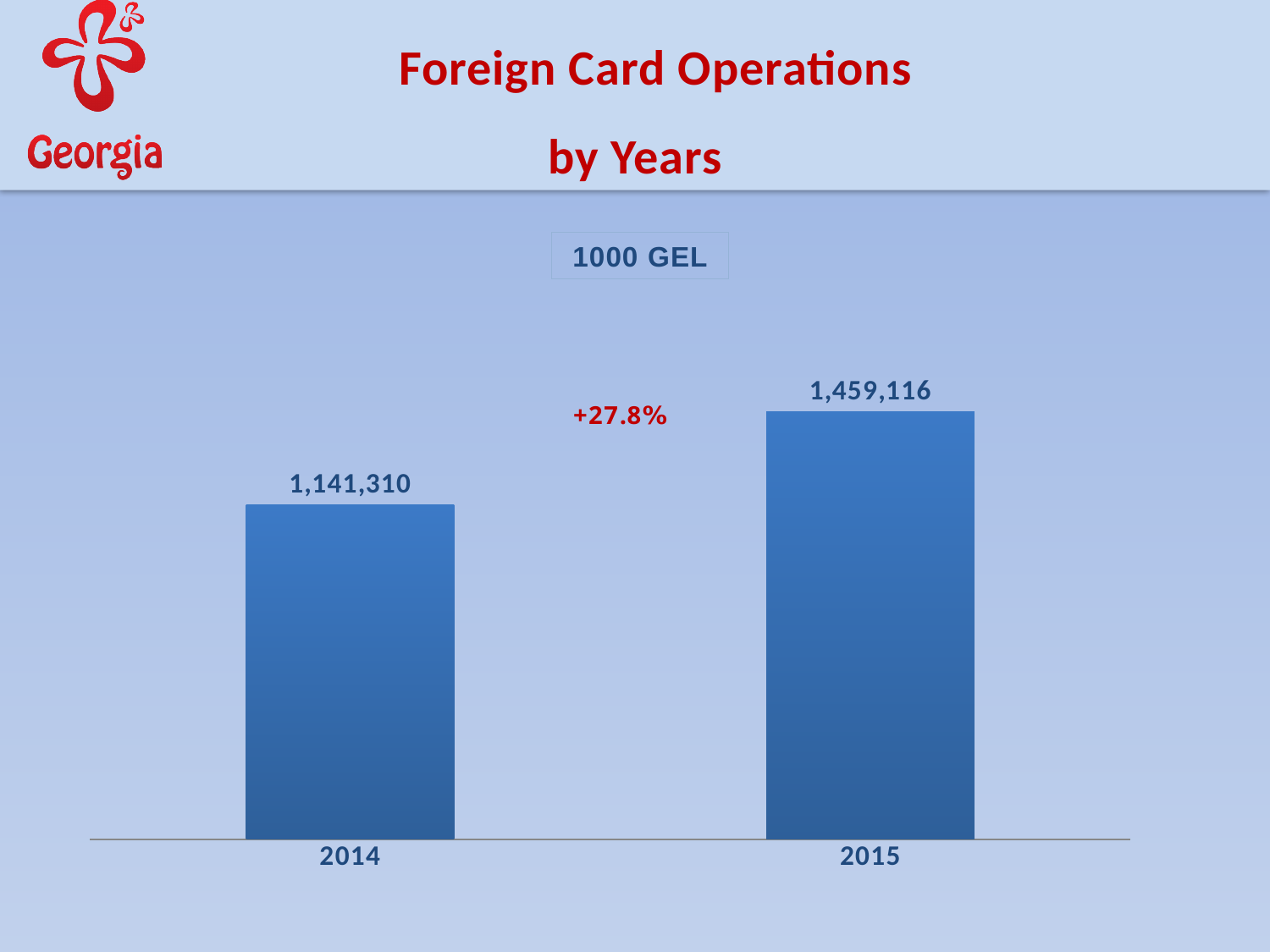
What is the value for 2015? 1,459,116 Which is larger, the value for 2014 or the value for 2015? 2015 What percentage change is annotated between 2014 and 2015? +27.8% How many years are shown on the chart? 2 What is the difference between the values for 2015 and 2014? 317,806 Do the values rise or fall from 2014 to 2015? rise What unit is shown in the label above the chart? 1000 GEL Which year has the highest value? 2015 What kind of chart is shown on the slide? bar chart Which year has the lowest value? 2014 What is the value for 2014? 1,141,310